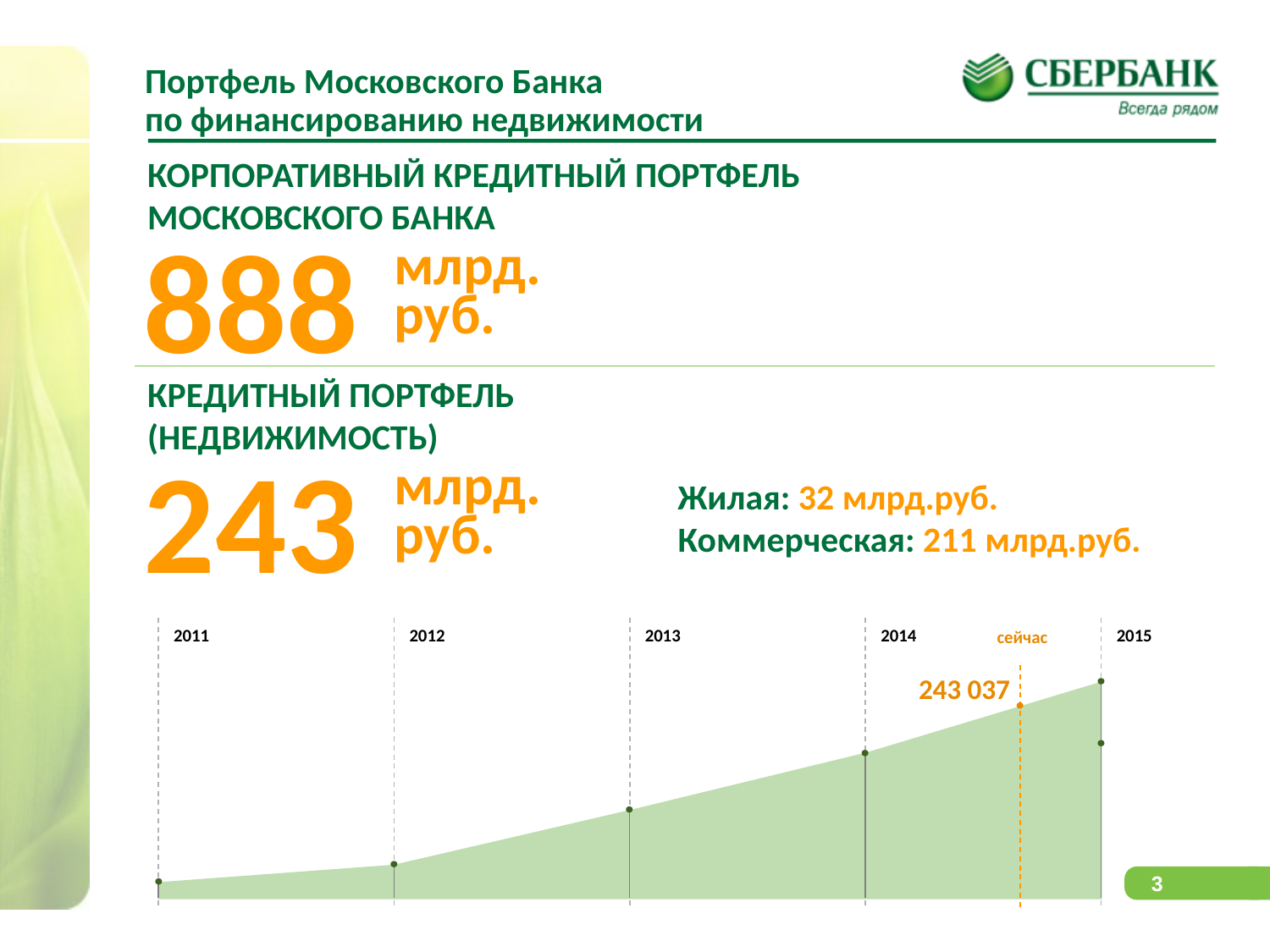
What value is labelled at the "сейчас" marker on the chart? 243 037 Which is larger on the chart, the value for 2014 or the value at "сейчас"? сейчас Which year on the chart has the highest value? 2015 What is the first year labelled on the chart's x axis? 2011 Do the values on the chart rise or fall from 2011 to 2015? rise What kind of chart is shown at the bottom of the slide? area chart What colour is the shaded area under the line on the chart? green Which is larger on the chart, the value for 2012 or the value for 2013? 2013 Which year on the chart has the lowest value? 2011 What is the last year labelled on the chart's x axis? 2015 How many years are labelled along the x axis of the chart? 5 Between which two years on the x axis is the "сейчас" marker placed? 2014 and 2015